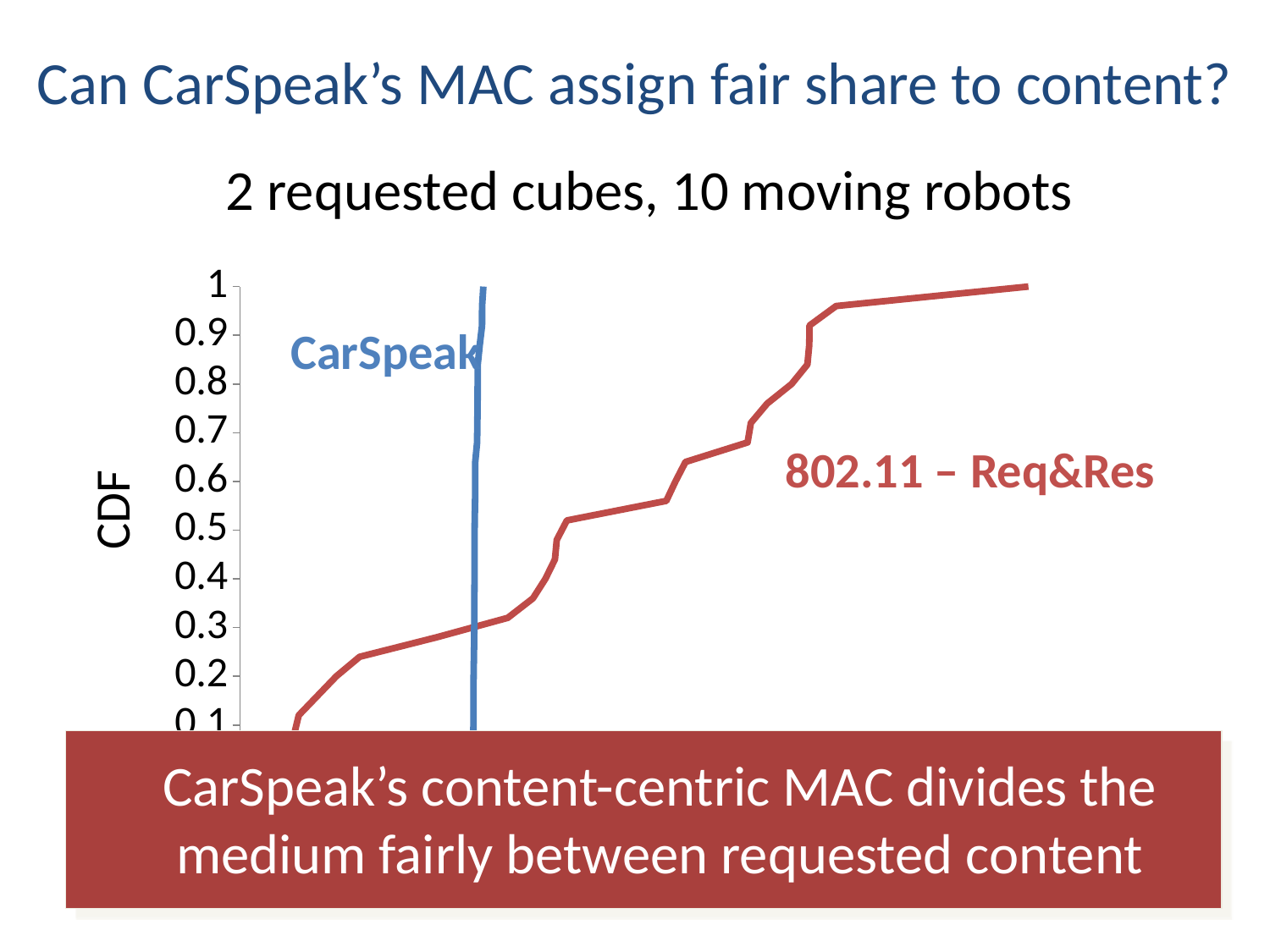
What is the label on the y axis of the chart? CDF What are the names of the two series plotted on the chart? CarSpeak and 802.11 – Req&Res Which series is drawn as a nearly vertical line, CarSpeak or 802.11 – Req&Res? CarSpeak What is the highest tick value shown on the y axis? 1 How many data series are plotted on the chart? 2 What kind of chart is shown on the slide? line chart Do the CDF values of the 802.11 – Req&Res line rise or fall along the x axis? rise